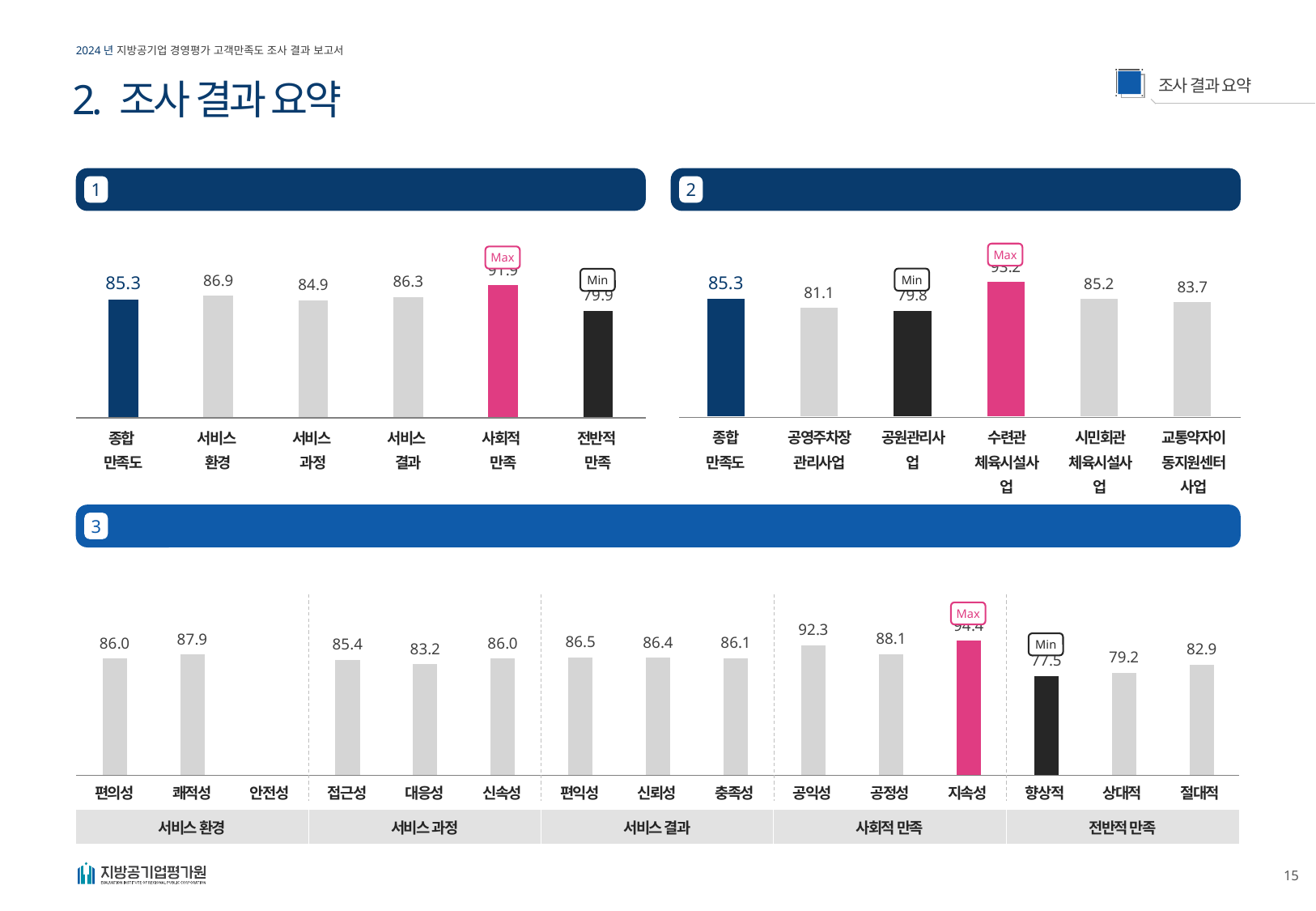
In the top-left chart, which category is marked as the minimum? 전반적 만족 In the bottom chart, what is the value for 공익성? 92.3 In the bottom chart, which category is marked as the minimum? 향상적 In the bottom chart, what is the difference between 쾌적성 and 편의성? 1.9 In the top-right chart, what is the value for 공영주차장 관리사업? 81.1 In the top-right chart, which category is marked as the maximum? 수련관 체육시설사업 What type of chart is the bottom chart? Bar chart In the top-left chart, what is the difference between 서비스 환경 and 서비스 과정? 2.0 In the top-right chart, how many bars are plotted? 6 In the top-left chart, which category is marked as the maximum? 사회적 만족 In the top-right chart, which is larger, 시민회관 체육시설사업 or 교통약자이동지원센터 사업? 시민회관 체육시설사업 In the top-left chart, what is the value for 서비스 환경? 86.9